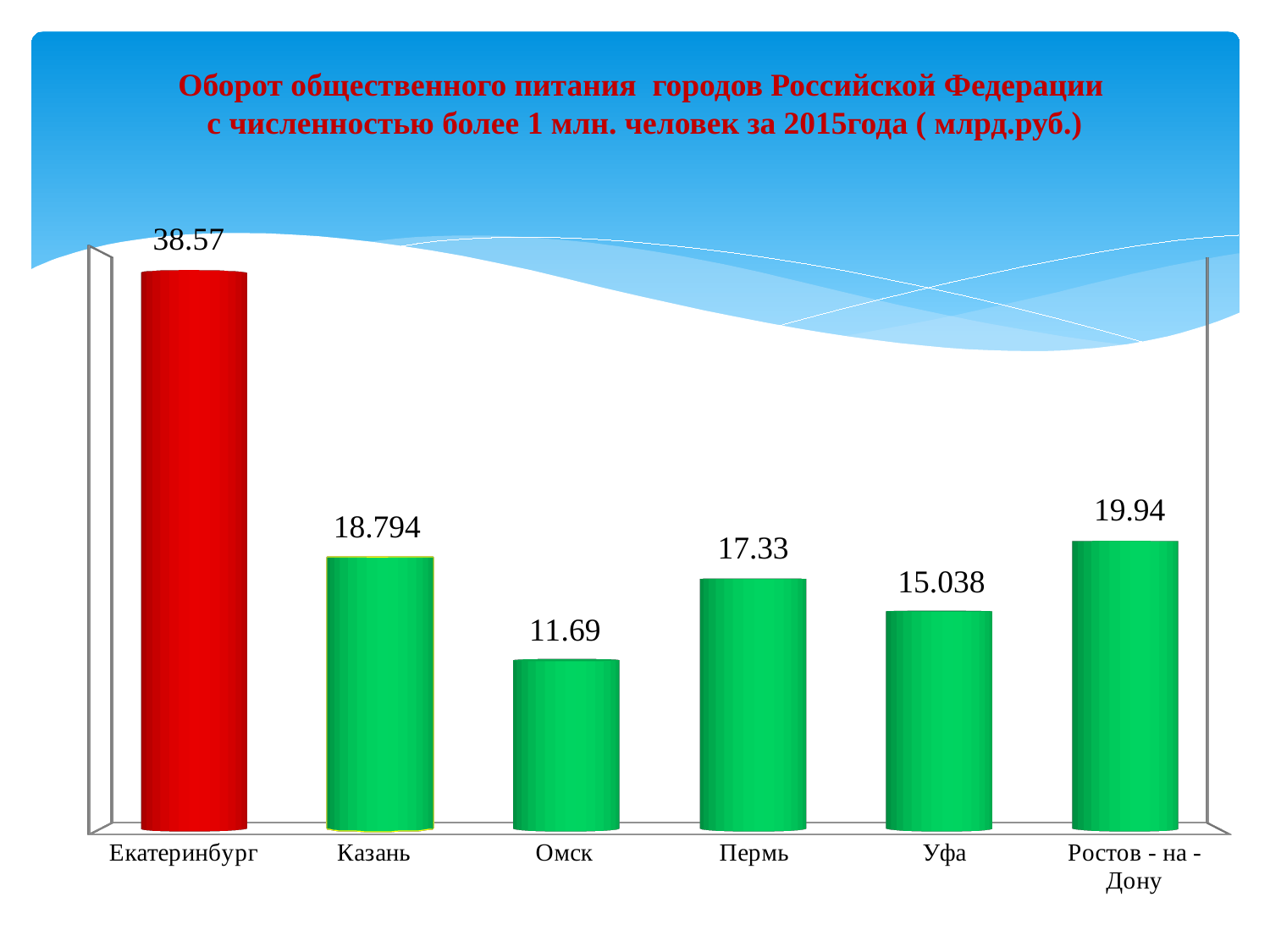
Which city has the lowest value? Омск How many cities are shown in the chart? 6 What is the difference between the values for Пермь and Омск? 5.64 What is the value for Екатеринбург? 38.57 What is the difference between the values for Екатеринбург and Ростов - на - Дону? 18.63 What kind of chart is shown on the slide? Bar chart Which city has the highest value? Екатеринбург Which is larger, the value for Пермь or the value for Уфа? Пермь What is the value for Уфа? 15.038 What is the value for Омск? 11.69 What is the value for Казань? 18.794 What is the value for Ростов - на - Дону? 19.94